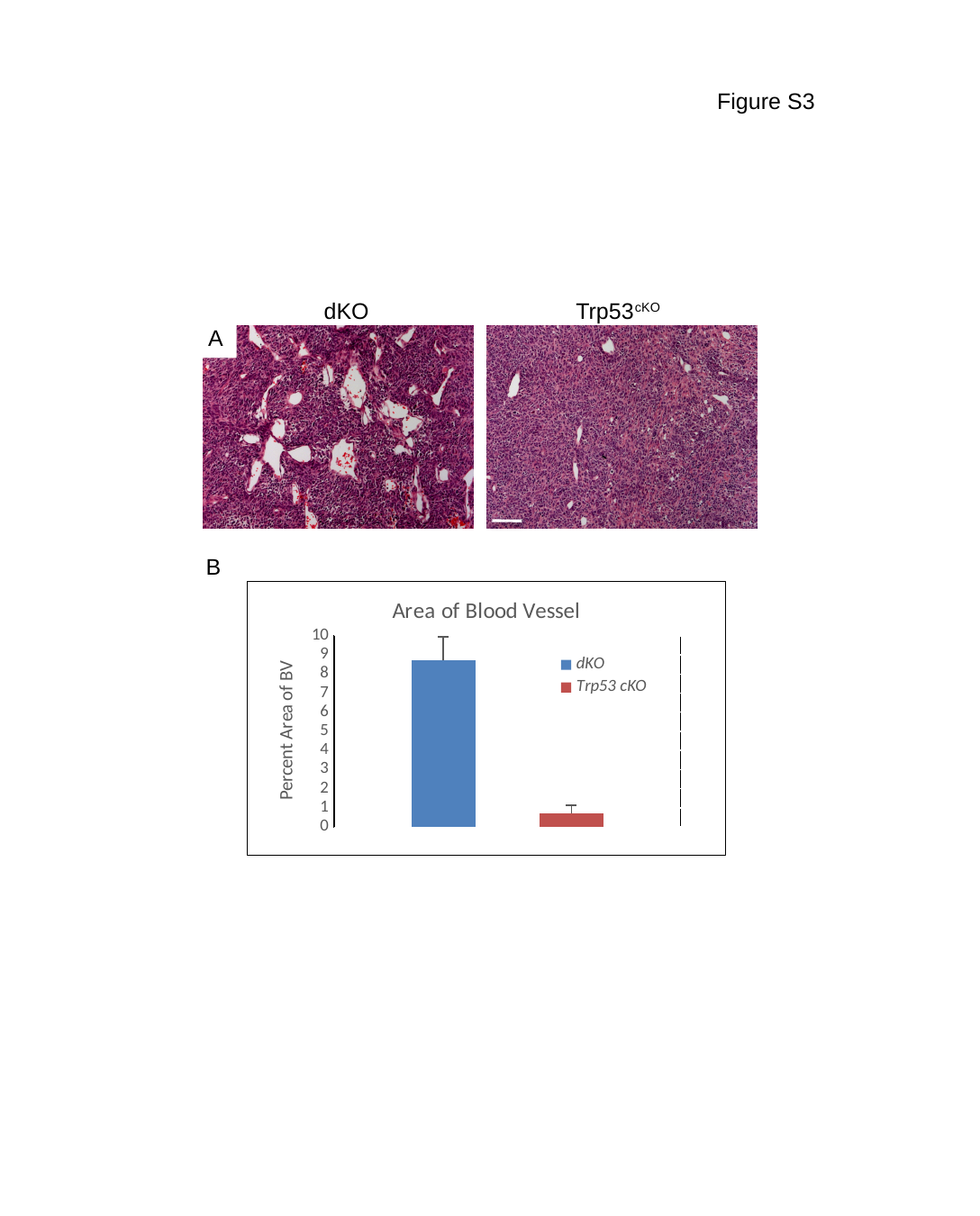
In the Area of Blood Vessel chart, is the value for dKO greater or less than 8? greater How many series does the legend of the Area of Blood Vessel chart list? 2 What is the label of the y axis in the Area of Blood Vessel chart? Percent Area of BV How many bars are plotted in the Area of Blood Vessel chart? 2 What is the title of the chart on the slide? Area of Blood Vessel Which series has the highest value in the Area of Blood Vessel chart? dKO What kind of chart is shown in panel B? bar chart In the Area of Blood Vessel chart, which is larger, the value for dKO or the value for Trp53 cKO? dKO Which series has the lowest value in the Area of Blood Vessel chart? Trp53 cKO In the Area of Blood Vessel chart, is the value for Trp53 cKO greater or less than 1? less In the Area of Blood Vessel chart, is the value for dKO greater or less than 9? less